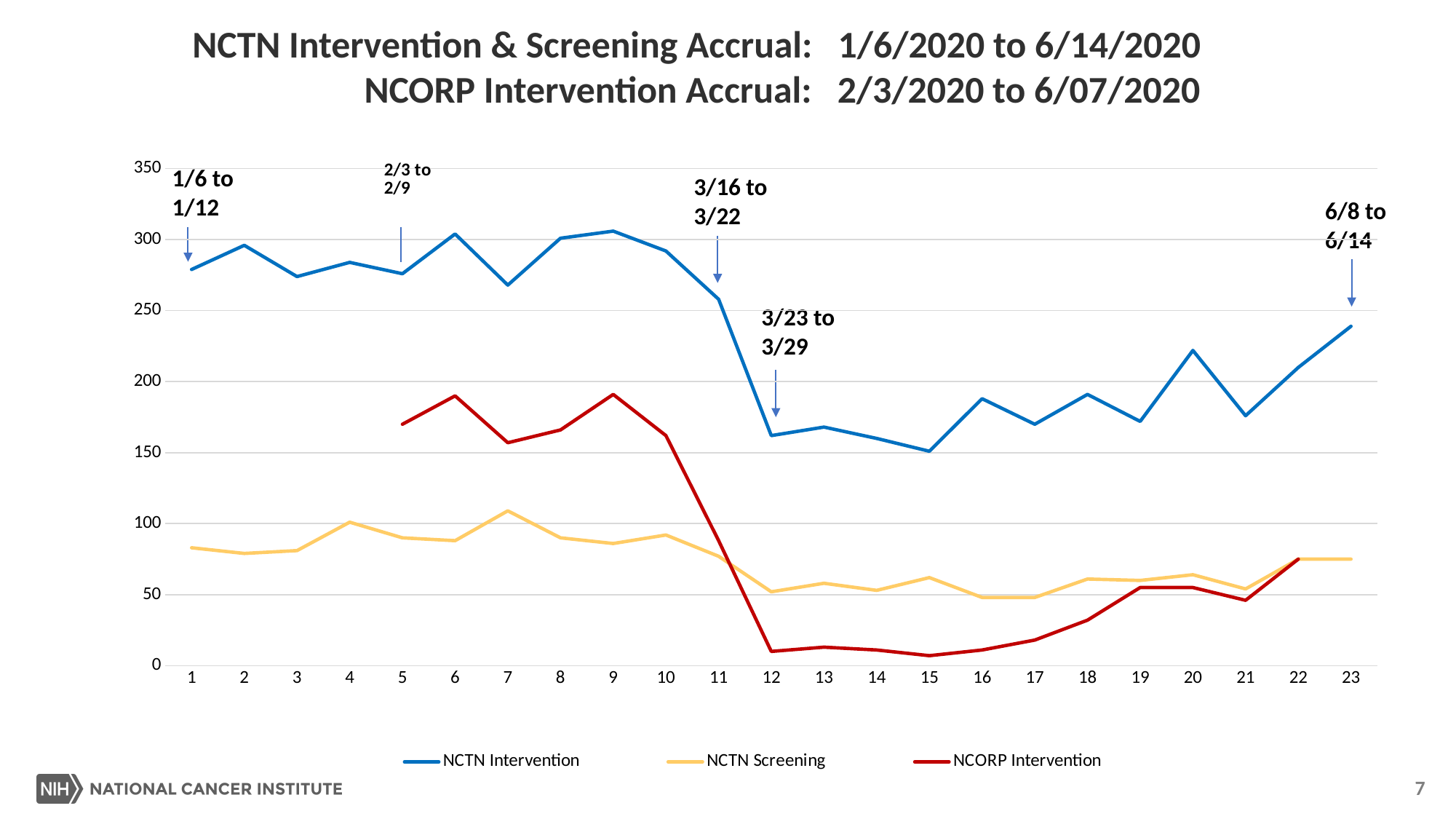
Is the value for NCTN Intervention at point 20 greater or less than 200? greater At which x-axis point does NCTN Screening reach its highest value? 7 At point 12, which series has the larger value: NCTN Screening or NCORP Intervention? NCTN Screening Does the NCTN Intervention line rise or fall from point 10 to point 12? fall Is the value for NCTN Intervention at point 12 greater or less than 200? less How many points are labelled along the x axis? 23 Which series in the legend is drawn in red? NCORP Intervention At which x-axis point does NCTN Intervention reach its lowest value? 15 What kind of chart is shown on the slide? line chart How many series does the legend list? 3 Is the value for NCTN Intervention at point 1 greater or less than 250? greater